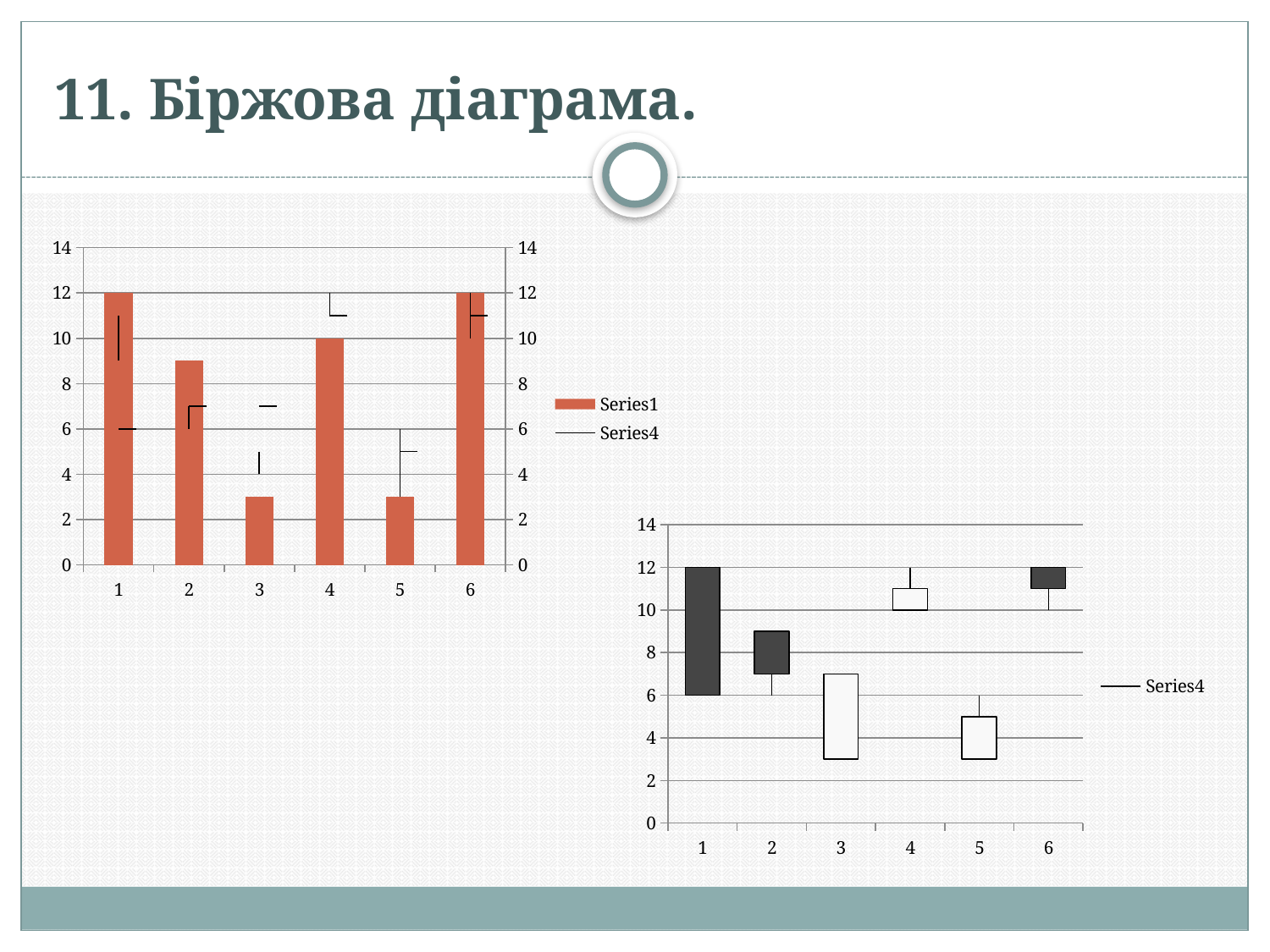
On the right chart, what is the top value of the box for category 1? 12 On the right chart, what is the bottom value of the box for category 1? 6 On the left chart, how many categories are shown on the x axis? 6 On the left chart, is the Series1 value for category 3 greater or less than 4? less On the left chart, what is the value of the Series1 bar for category 6? 12 What kind of chart is the chart on the right of the slide? stock (candlestick) chart On the left chart, what is the value of the Series1 bar for category 1? 12 On the left chart, is the Series1 value for category 2 greater or less than 8? greater On the right chart, how many series does the legend list? 1 On the left chart, which Series1 bar is taller, category 1 or category 2? category 1 On the left chart, how many series does the legend list? 2 On the left chart, what is the value of the Series1 bar for category 4? 10